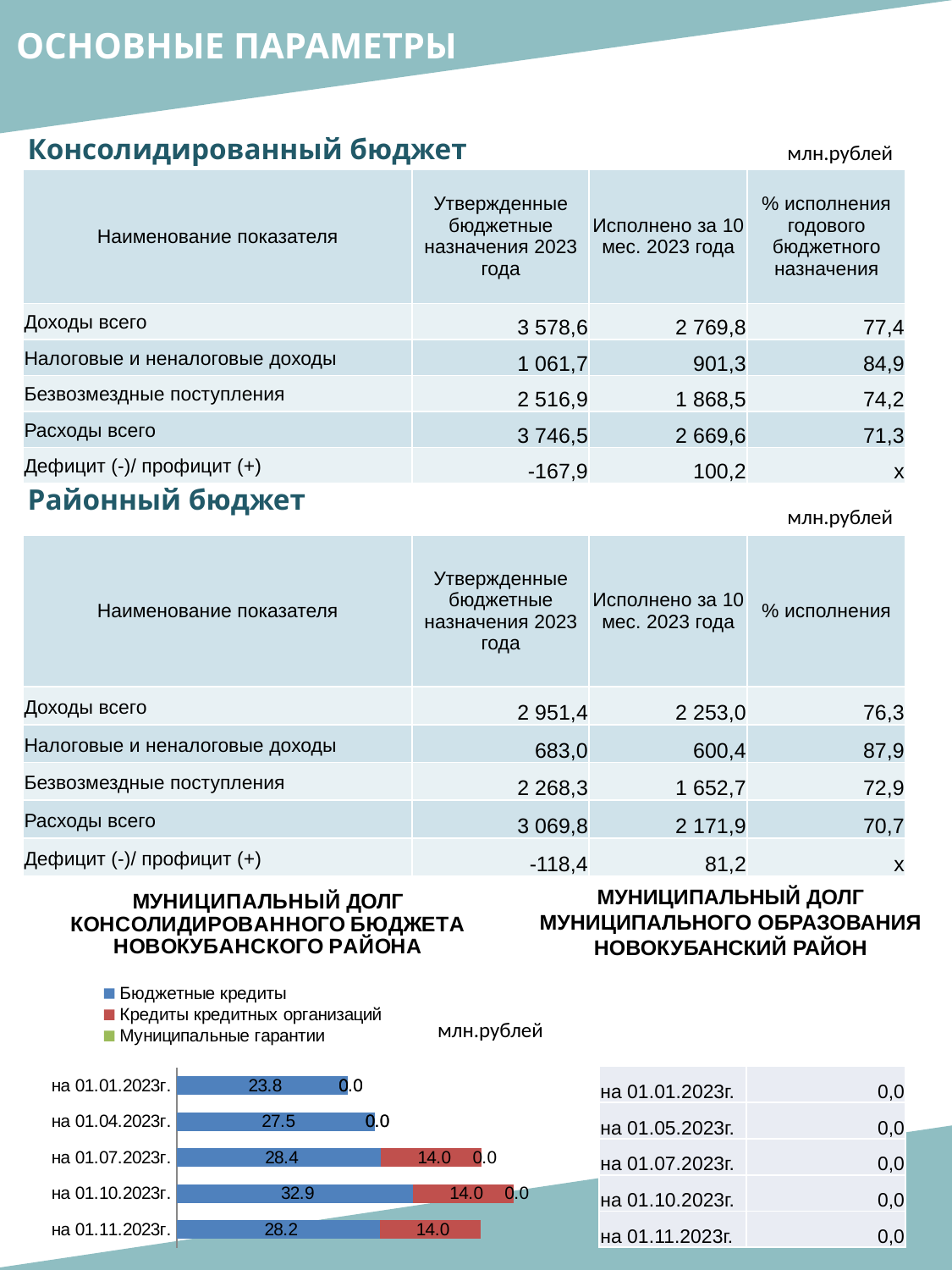
What kind of chart is shown on the slide? bar chart What is the value of Кредиты кредитных организаций on 01.11.2023г.? 14.0 What is the value of Бюджетные кредиты on 01.10.2023г.? 32.9 How many series does the chart legend list? 3 What is the difference between Бюджетные кредиты on 01.10.2023г. and on 01.11.2023г.? 4.7 How many dates (categories) are shown on the chart? 5 Which colour represents Кредиты кредитных организаций in the chart? red Which is larger: Бюджетные кредиты on 01.04.2023г. or on 01.07.2023г.? на 01.07.2023г. What is the value of Бюджетные кредиты on 01.01.2023г.? 23.8 What is the total of the stacked bar for 01.10.2023г.? 46.9 On which date is the value of Бюджетные кредиты the lowest? на 01.01.2023г. On which date is the value of Бюджетные кредиты the highest? на 01.10.2023г.